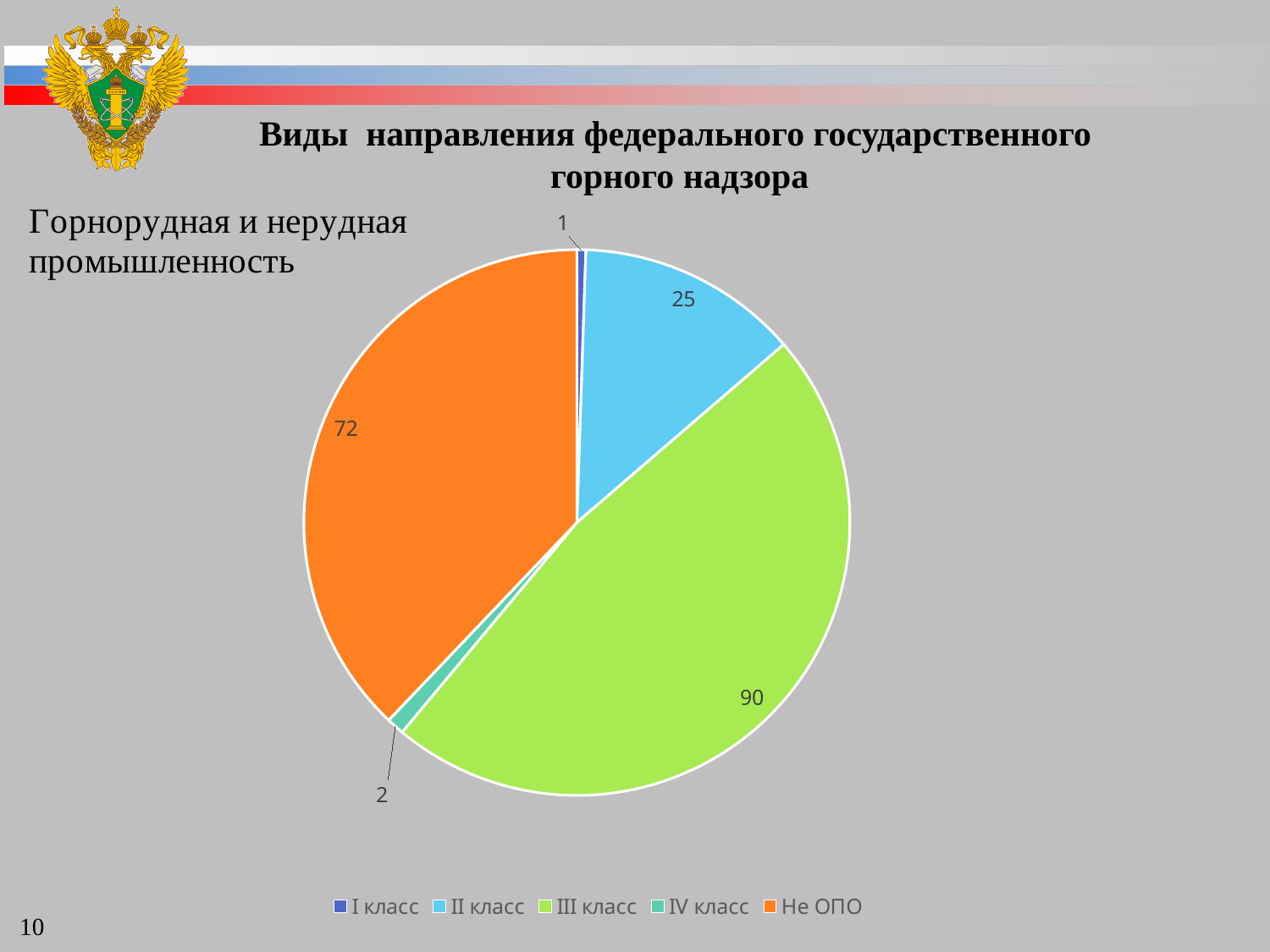
What kind of chart is shown on the slide? pie chart How many categories does the legend list? 5 Which category has the largest slice of the pie? III класс What is the value for Не ОПО? 72 What is the total of all the values shown on the pie chart? 190 What is the value for I класс? 1 Which is larger, the value for II класс or the value for Не ОПО? Не ОПО What is the value for IV класс? 2 What is the value for III класс? 90 Which category has the smallest slice of the pie? I класс What is the value for II класс? 25 What is the difference between the values for III класс and Не ОПО? 18